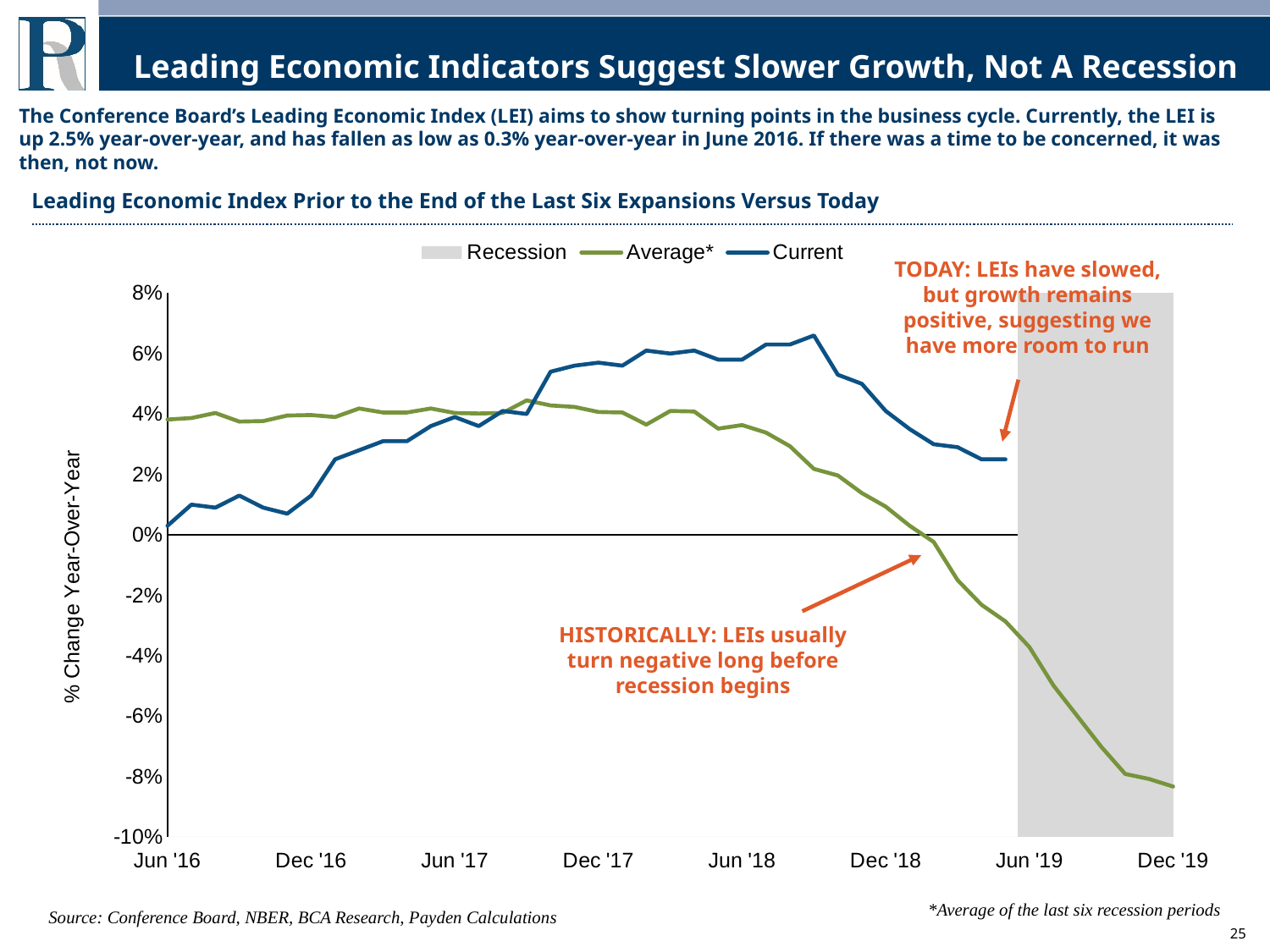
What is the title of the chart? Leading Economic Index Prior to the End of the Last Six Expansions Versus Today Is the value of the Average* line at Dec '19 greater or less than -6%? less How many entries does the chart legend list? 3 Does the Average* line rise or fall between Jun '18 and Dec '19? Fall Is the value of the Current line at Jun '19 greater or less than 4%? less At Jun '18, which line is higher, Average* or Current? Current Is the value of the Current line at Jun '16 greater or less than 2%? less What is the label on the y-axis of the chart? % Change Year-Over-Year At Jun '16, which line is higher, Average* or Current? Average* What kind of chart is shown on the slide? Line chart